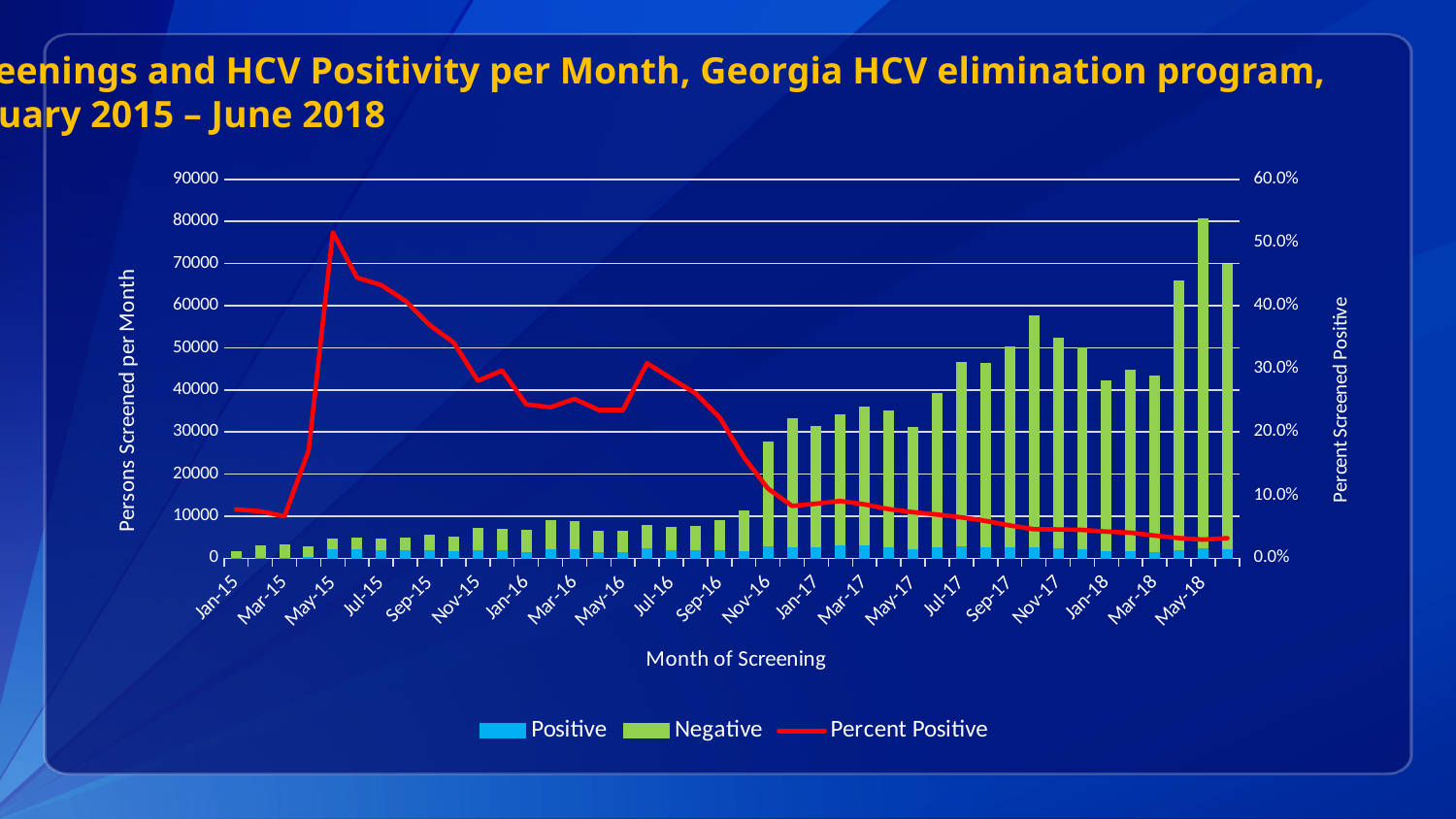
Is the total number of persons screened in Jan-15 greater or less than 10000? less Does the Percent Positive line rise or fall from Jul-16 to May-18? Falls What kind of chart is this? A bar chart with a line overlay (stacked bars plus a line) Which month has the higher Percent Positive value, May-15 or May-18? May-15 How many series does the legend list? 3 Is the Percent Positive value for Jan-15 greater or less than 10.0%? less Is the Percent Positive value for May-18 greater or less than 10.0%? less What colour represents the Negative series in the legend? Green Do the bars for persons screened per month generally rise or fall from Jan-15 to May-18? Rise How many month labels are shown on the x axis? 21 Which month has the taller bar for persons screened, Jan-15 or Nov-16? Nov-16